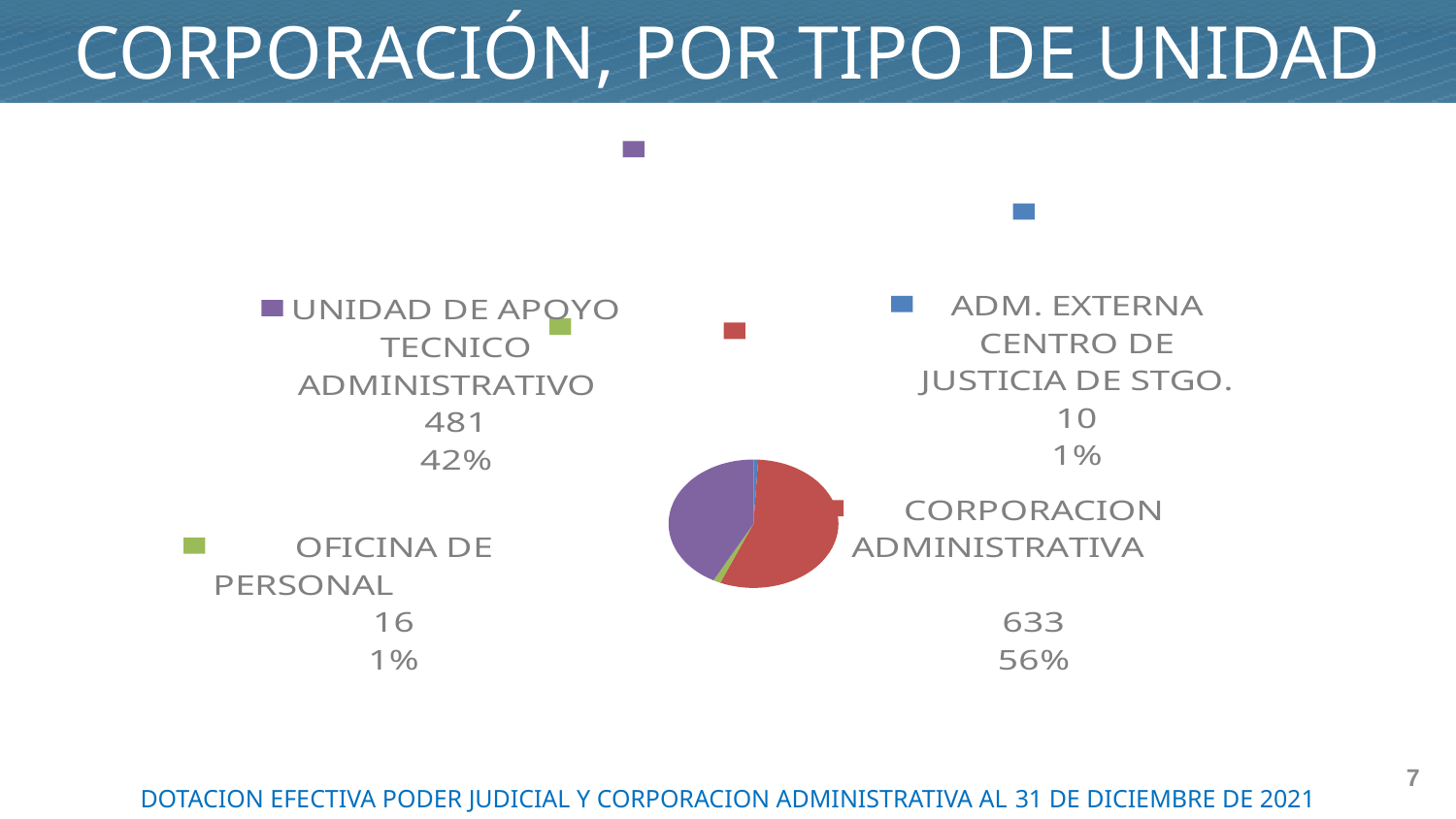
What is the value for UNIDAD DE APOYO TECNICO ADMINISTRATIVO? 481 Which is larger, the value for OFICINA DE PERSONAL or the value for ADM. EXTERNA CENTRO DE JUSTICIA DE STGO.? OFICINA DE PERSONAL What share of the pie does CORPORACION ADMINISTRATIVA represent? 56% What is the value for ADM. EXTERNA CENTRO DE JUSTICIA DE STGO.? 10 What share of the pie does UNIDAD DE APOYO TECNICO ADMINISTRATIVO represent? 42% Which category has the lowest value? ADM. EXTERNA CENTRO DE JUSTICIA DE STGO. What is the value for OFICINA DE PERSONAL? 16 How many categories does the pie chart show? 4 What kind of chart is shown on the slide? pie chart What is the value for CORPORACION ADMINISTRATIVA? 633 What is the difference between the values for CORPORACION ADMINISTRATIVA and UNIDAD DE APOYO TECNICO ADMINISTRATIVO? 152 Which category has the highest value? CORPORACION ADMINISTRATIVA